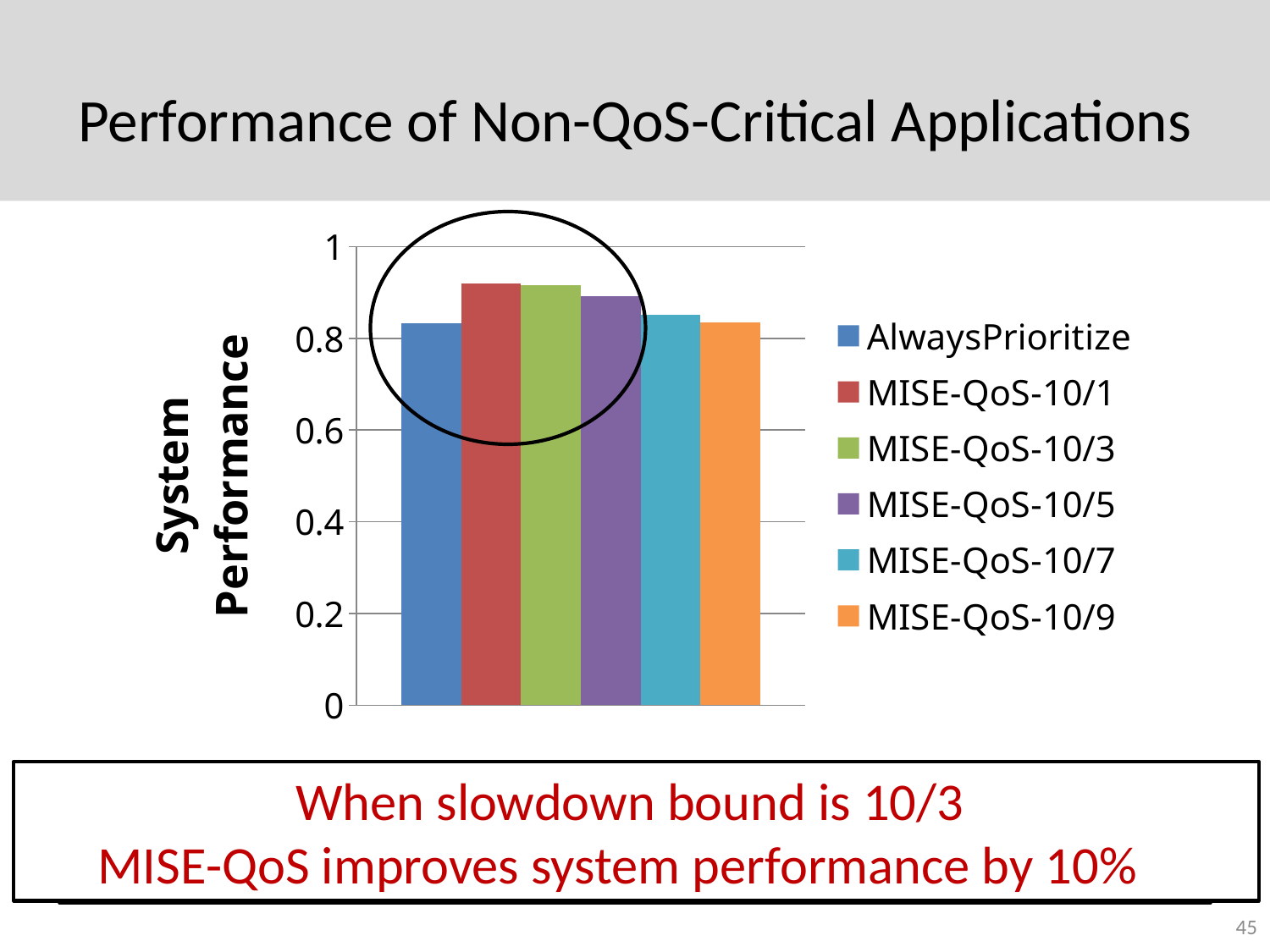
Which is larger, the value for MISE-QoS-10/3 or the value for MISE-QoS-10/7? MISE-QoS-10/3 What is the label on the vertical axis of the chart? System Performance Which is larger, the value for MISE-QoS-10/5 or the value for MISE-QoS-10/9? MISE-QoS-10/5 Which is larger, the value for MISE-QoS-10/1 or the value for AlwaysPrioritize? MISE-QoS-10/1 Is the value for MISE-QoS-10/1 greater or less than 1? less Is the value for AlwaysPrioritize greater or less than 0.8? greater Is the value for MISE-QoS-10/5 greater or less than 0.6? greater Which legend entry is listed first? AlwaysPrioritize How many series does the legend list? 6 How many bars are plotted in the chart? 6 What kind of chart is shown on the slide? bar chart